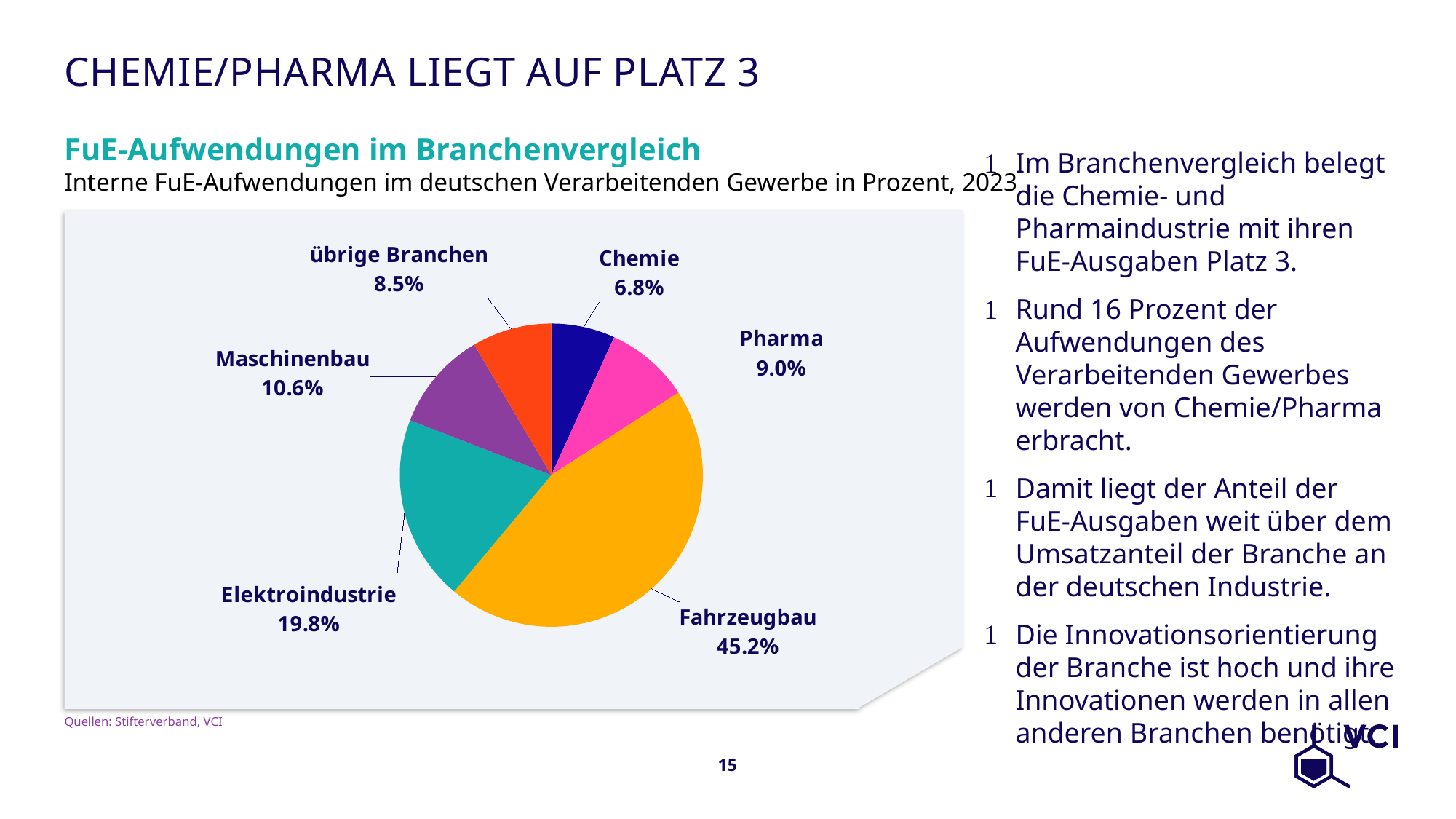
What is the combined share of Chemie and Pharma? 15.8% What is the difference between the values for Fahrzeugbau and Elektroindustrie? 25.4 percentage points What share of the pie does Fahrzeugbau have? 45.2% What is the value shown for Pharma? 9.0% What is the title of the chart? FuE-Aufwendungen im Branchenvergleich Which category has the largest slice of the pie? Fahrzeugbau Which category has the smallest slice of the pie? Chemie What is the value shown for Elektroindustrie? 19.8% Which is larger, the value for Maschinenbau or the value for übrige Branchen? Maschinenbau What kind of chart is shown on the slide? Pie chart What is the value shown for Maschinenbau? 10.6% How many categories are shown in the pie chart? 6